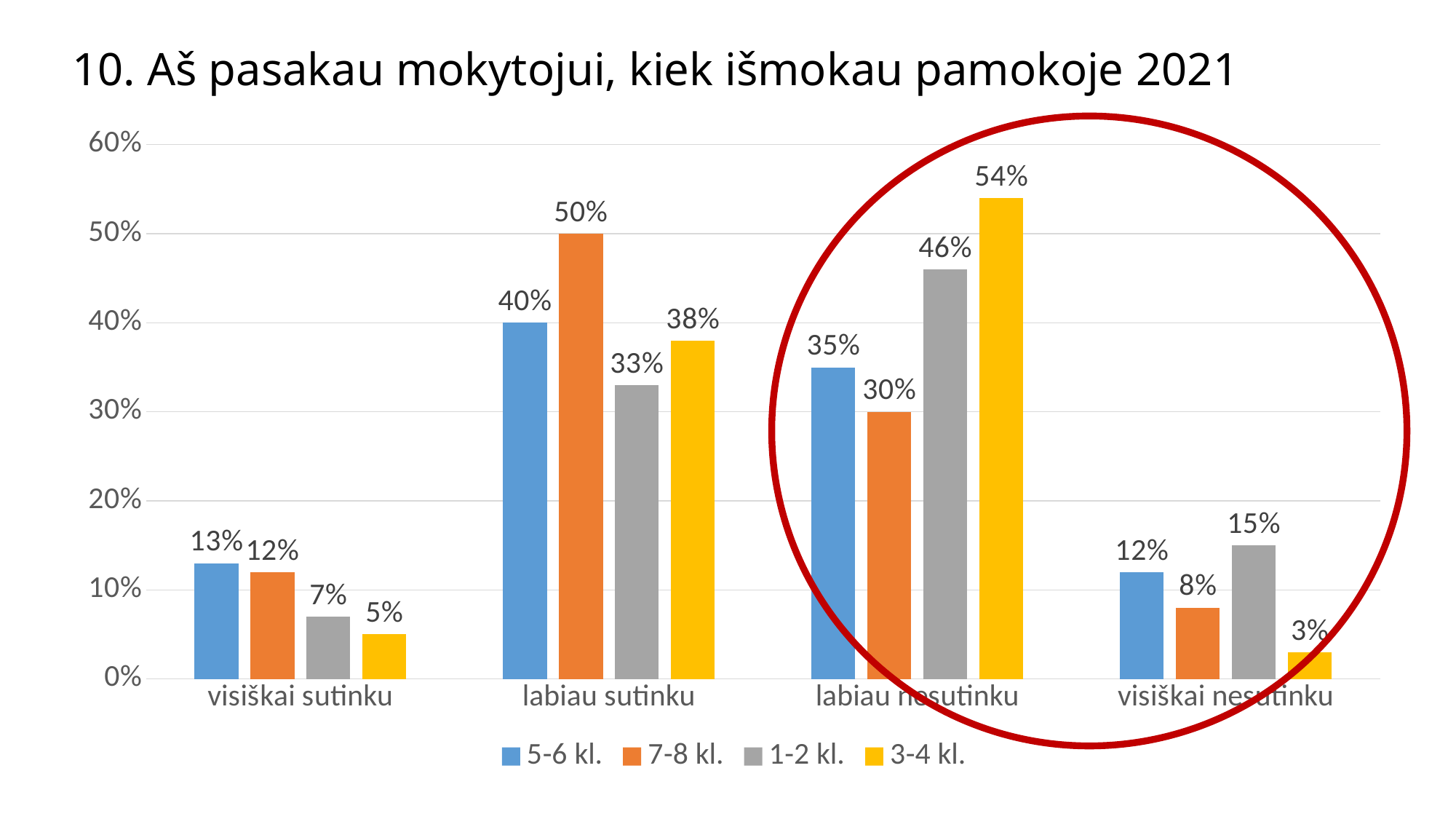
Is the value for 1-2 kl. in the 'labiau nesutinku' category greater or less than 40%? greater What kind of chart is shown on the slide? Bar chart How many series does the legend list? 4 Which series has the highest value in the 'labiau nesutinku' category? 3-4 kl. In the 'visiškai nesutinku' category, which is larger: the value for 5-6 kl. or the value for 7-8 kl.? 5-6 kl. What is the value for 7-8 kl. in the 'labiau sutinku' category? 50% How many categories are shown on the x axis? 4 What is the value for 3-4 kl. in the 'labiau nesutinku' category? 54% What is the difference between the 7-8 kl. and 5-6 kl. values in the 'labiau sutinku' category? 10% Which series has the lowest value in the 'visiškai sutinku' category? 3-4 kl. What is the value for 1-2 kl. in the 'visiškai nesutinku' category? 15% What is the title of the chart? 10. Aš pasakau mokytojui, kiek išmokau pamokoje 2021